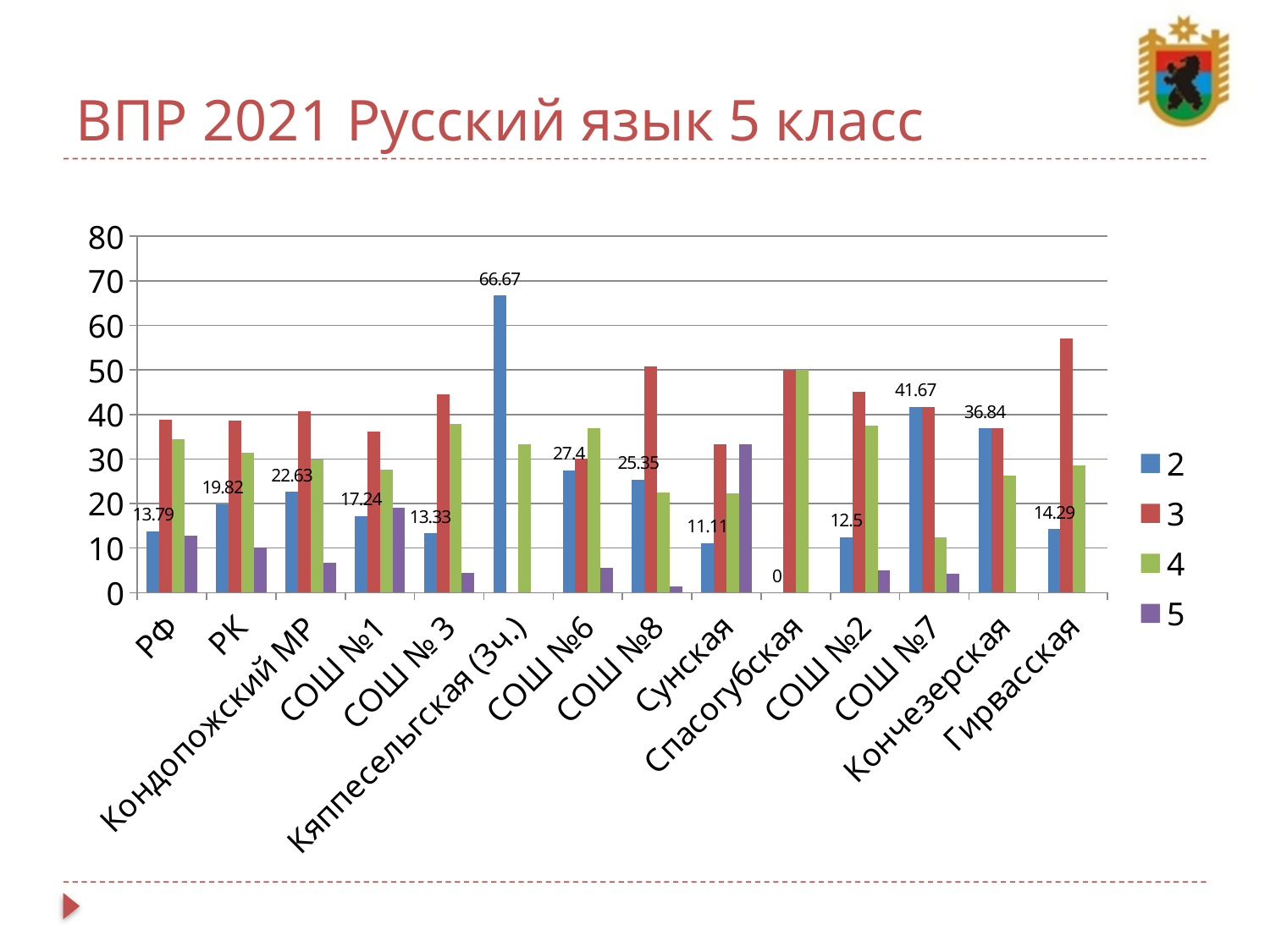
What is the difference between the series "2" values for РК and РФ? 6.03 How many categories are shown on the x axis? 14 Is the value of series "3" for Гирвасская greater or less than 50? greater Which is larger for series "2": Кончезерская or СОШ №7? СОШ №7 What is the value of series "2" for СОШ №7? 41.67 Which category has the highest value for series "2"? Кяппесельгская (3ч.) What is the value of series "2" for РФ? 13.79 What is the value of series "2" for Спасогубская? 0 What kind of chart is shown on the slide? bar chart How many series does the legend list? 4 What is the value of series "2" for Кяппесельгская (3ч.)? 66.67 Which category has the lowest value for series "2"? Спасогубская